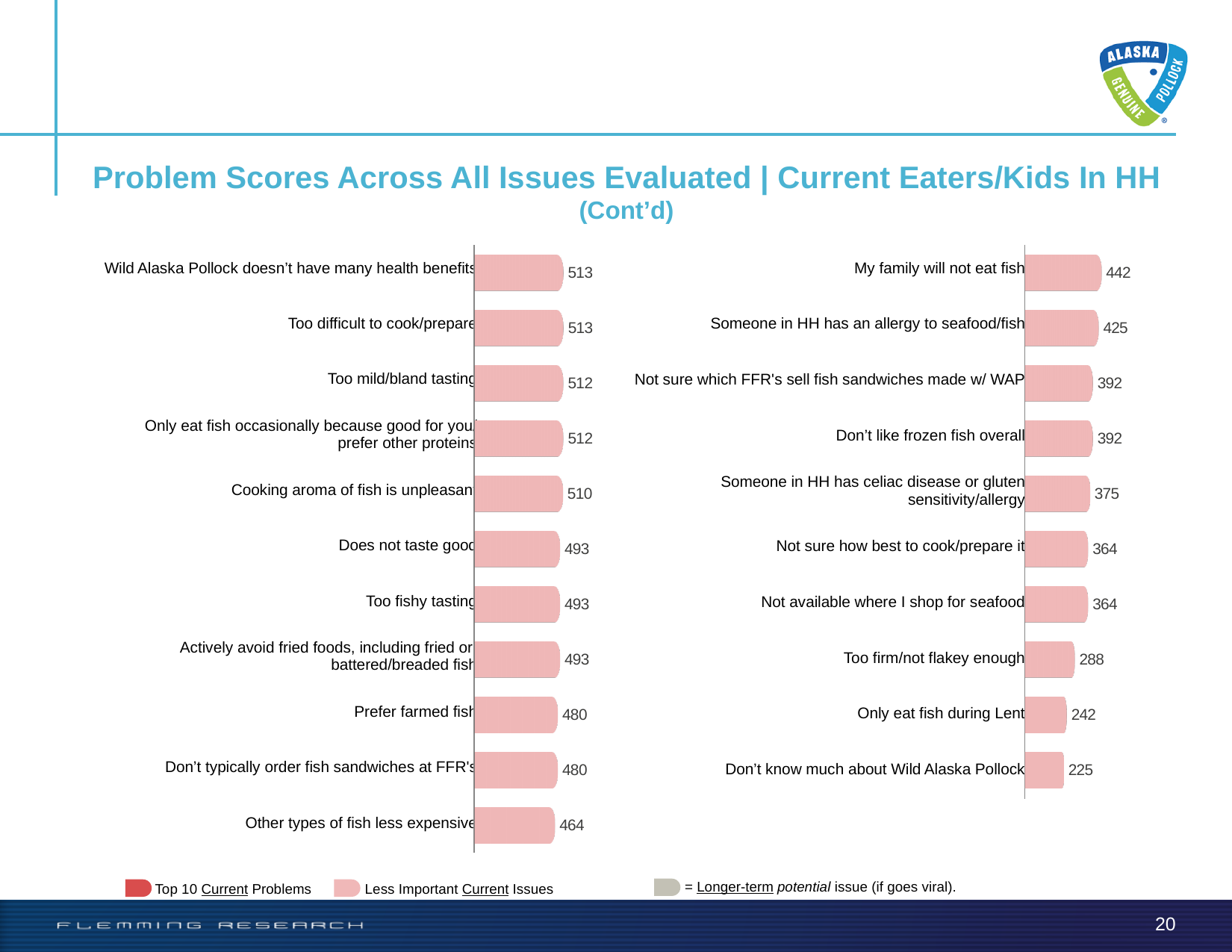
In the right chart, what is the difference between the values for "My family will not eat fish" and "Only eat fish during Lent"? 200 In the left chart, what is the value for "Other types of fish less expensive"? 464 In the right chart, what is the value for "My family will not eat fish"? 442 What type of chart is the right chart? Bar chart In the left chart, which category has the lowest value? Other types of fish less expensive In the right chart, which category has the highest value? My family will not eat fish In the right chart, which category has the lowest value? Don't know much about Wild Alaska Pollock In the left chart, what is the difference between the values for "Cooking aroma of fish is unpleasant" and "Prefer farmed fish"? 30 In the right chart, which is larger: the value for "Someone in HH has an allergy to seafood/fish" or the value for "Don't like frozen fish overall"? Someone in HH has an allergy to seafood/fish How many categories are shown in the left chart? 11 In the right chart, what is the value for "Too firm/not flakey enough"? 288 In the left chart, what is the value for "Too mild/bland tasting"? 512